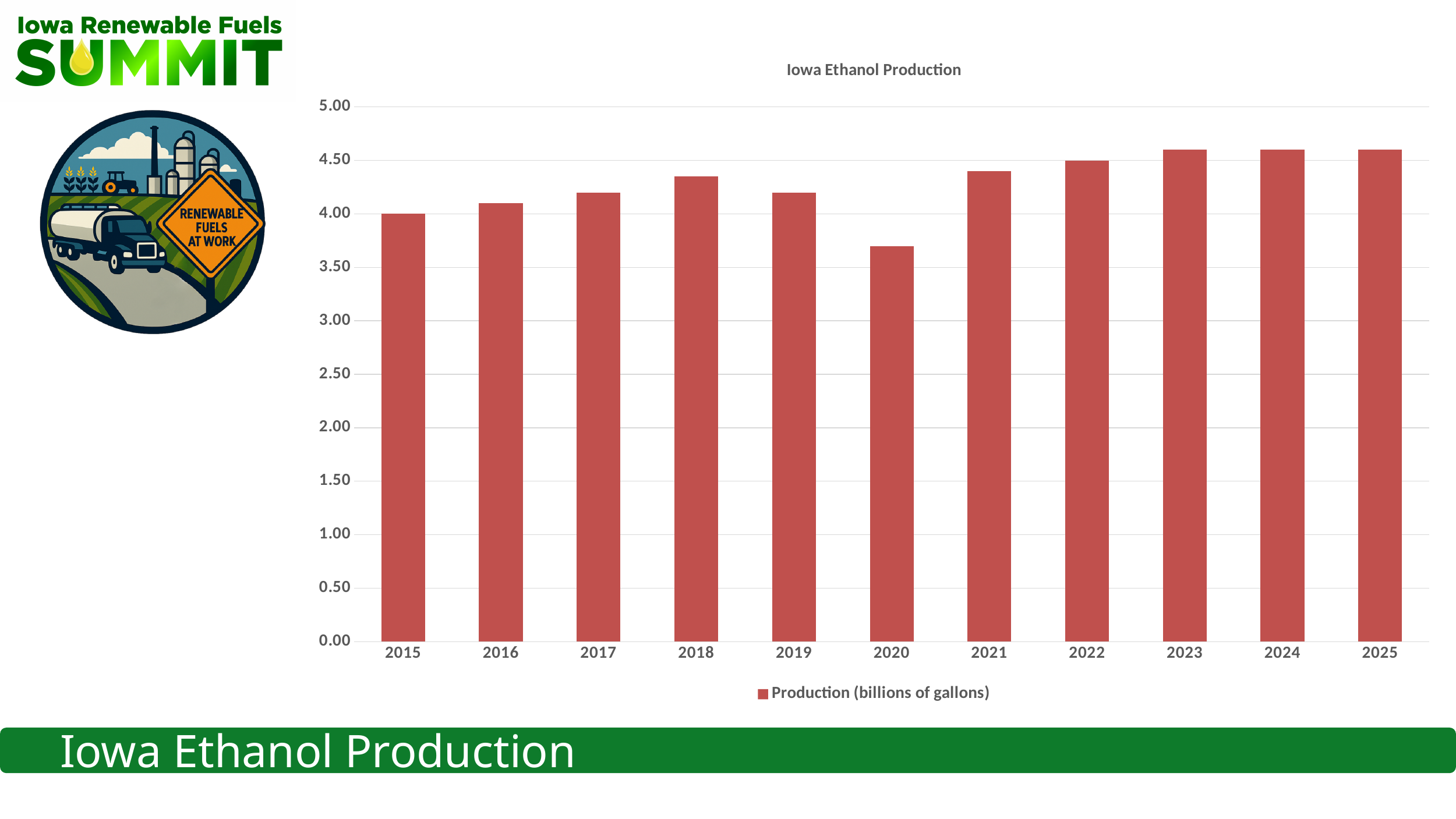
Which year has the lowest ethanol production in the chart? 2020 What is the production value for 2022? 4.50 Is the value for 2023 greater or less than 4.50? greater What is the legend entry for the series in the chart? Production (billions of gallons) What is the production value for 2015? 4.00 Which year has the higher production, 2018 or 2019? 2018 Is the value for 2020 greater or less than 4.00? less Is the value for 2021 greater or less than 4.50? less What kind of chart is shown on the slide? Bar chart Do the production values rise or fall from 2015 to 2018? rise How many years are shown on the x axis of the Iowa Ethanol Production chart? 11 How many series does the legend list? 1